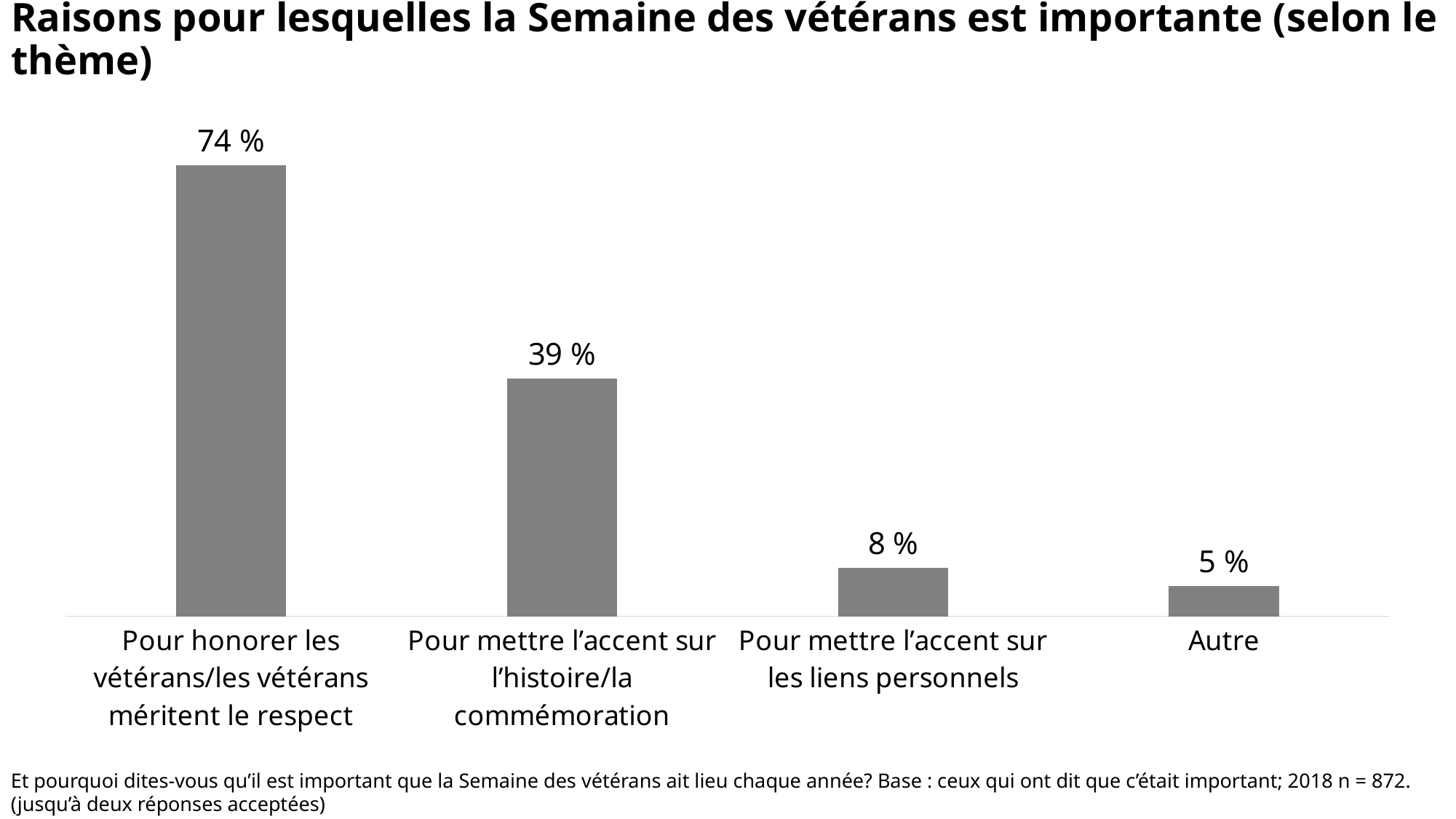
What is the value for "Pour mettre l'accent sur l'histoire/la commémoration"? 39 % Which category has the lowest value? Autre Which category has the highest value? Pour honorer les vétérans/les vétérans méritent le respect What is the value for "Autre"? 5 % What is the value for "Pour honorer les vétérans/les vétérans méritent le respect"? 74 % What is the difference between the values for "Pour honorer les vétérans/les vétérans méritent le respect" and "Pour mettre l'accent sur l'histoire/la commémoration"? 35 % How many categories are shown in the chart? 4 What kind of chart is shown on the slide? Bar chart Do the values rise or fall from left to right across the categories? Fall What is the difference between the values for "Pour mettre l'accent sur les liens personnels" and "Autre"? 3 % Which is larger: the value for "Pour mettre l'accent sur l'histoire/la commémoration" or the value for "Pour mettre l'accent sur les liens personnels"? Pour mettre l'accent sur l'histoire/la commémoration What is the value for "Pour mettre l'accent sur les liens personnels"? 8 %